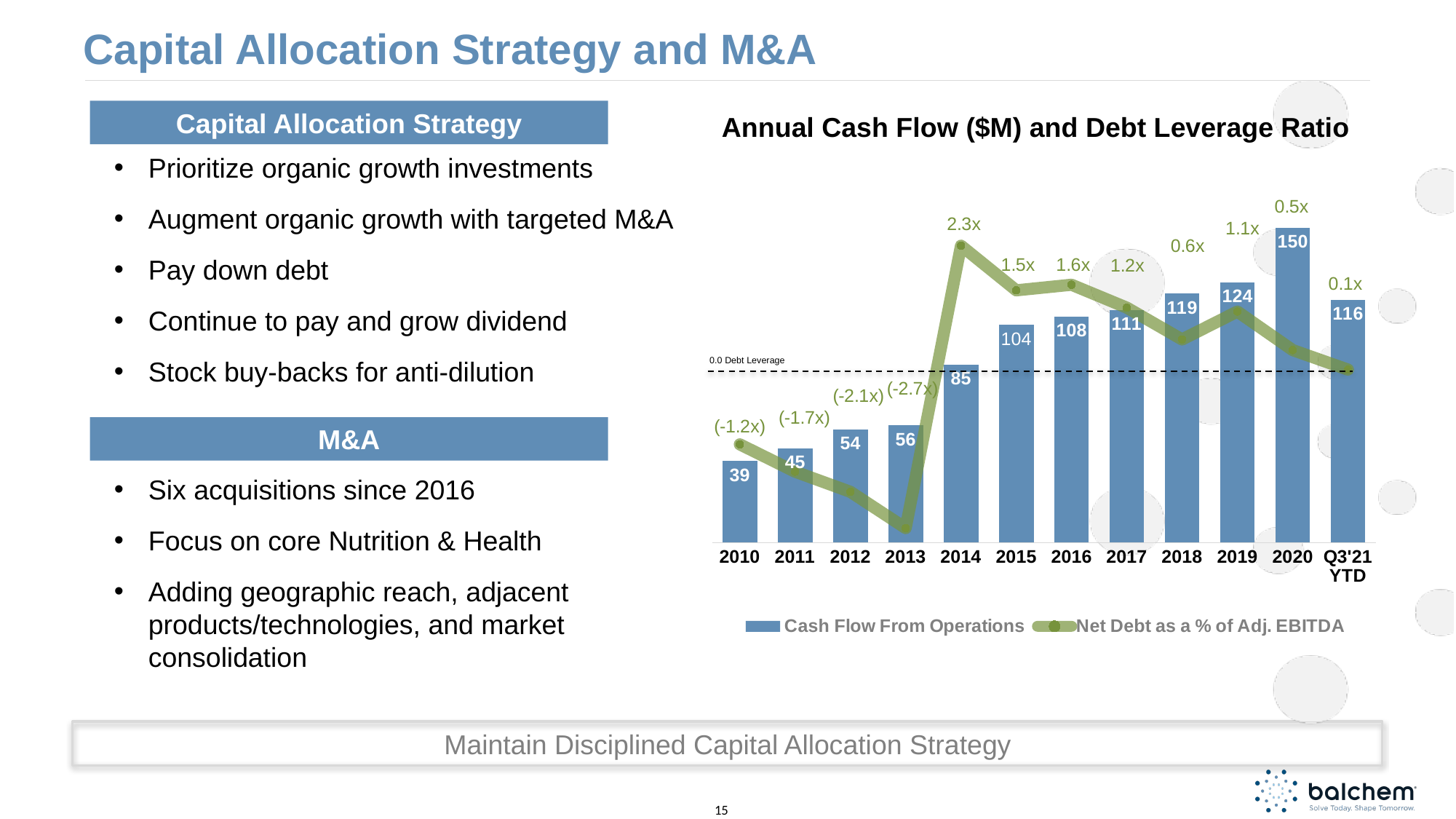
What is the Cash Flow From Operations value for 2010? 39 What is the difference in Cash Flow From Operations between 2020 and 2019? 26 What is the Net Debt as a % of Adj. EBITDA value for 2013? (-2.7x) What kind of chart is used to show Cash Flow From Operations? Bar chart What is the Cash Flow From Operations value for 2020? 150 How many periods are shown on the x axis of the chart? 12 What is the Net Debt as a % of Adj. EBITDA value for 2014? 2.3x What is the title of the chart? Annual Cash Flow ($M) and Debt Leverage Ratio Which year has the lowest Cash Flow From Operations? 2010 Which is larger, the Cash Flow From Operations for 2015 or for 2016? 2016 How many series does the legend list? 2 Which year has the highest Cash Flow From Operations? 2020